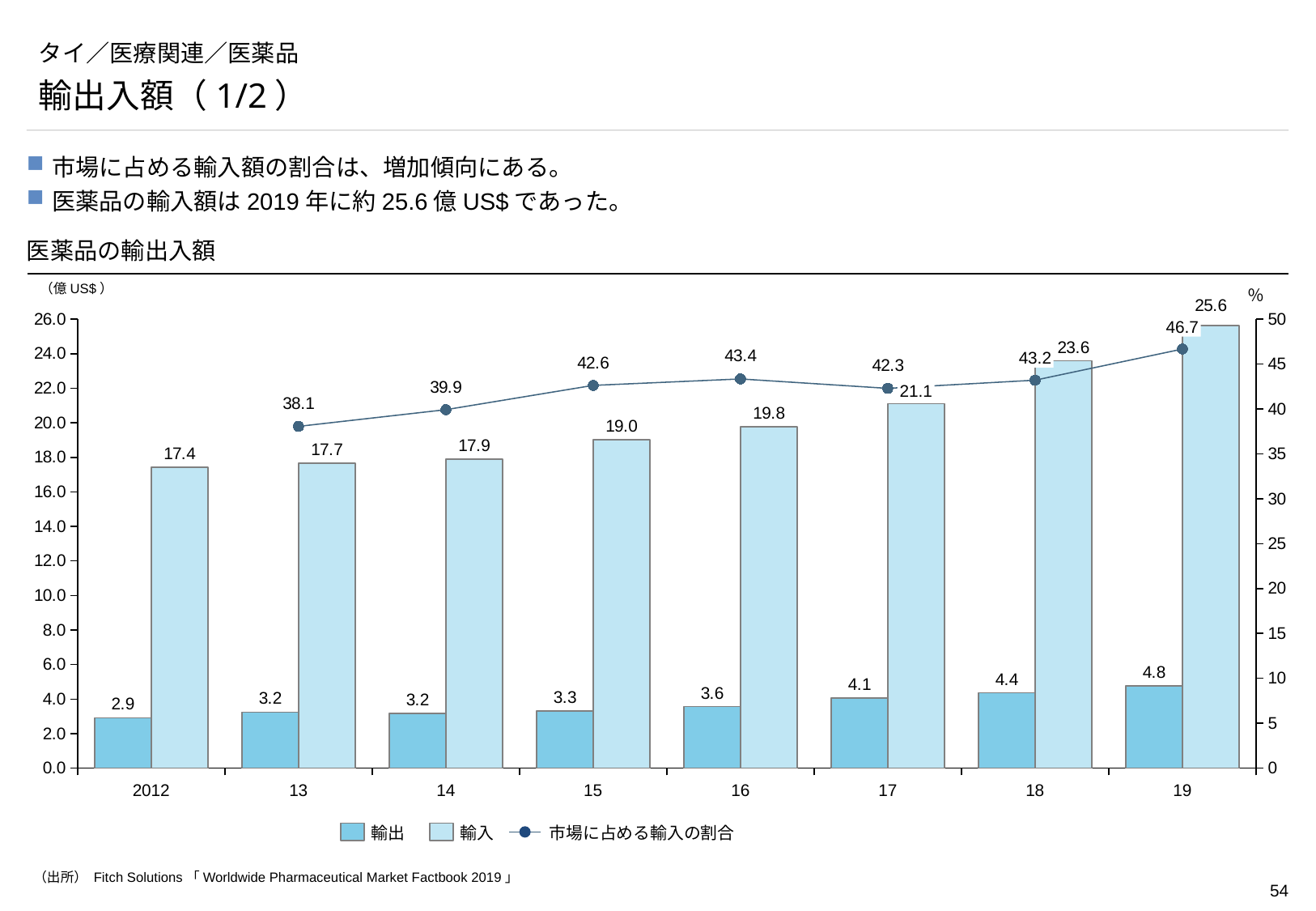
Which year has the lowest 市場に占める輸入の割合 value? 13 Which year has the highest 輸入 (import) value? 19 How many series does the legend list? 3 What kind of chart is this? Combined bar and line chart What is the 輸出 (export) value for 2012? 2.9 What is the difference between the 輸入 value for 2019 and the 輸入 value for 2012? 8.2 What is the 輸入 (import) value for 2019? 25.6 What is the title of the chart? 医薬品の輸出入額 How many years are shown on the x axis? 8 What is the 市場に占める輸入の割合 value for 2016? 43.4 Do the 輸入 (import) values rise or fall from 2012 to 2019? Rise Which is larger, the 輸出 value for 2017 or the 輸出 value for 2015? 2017